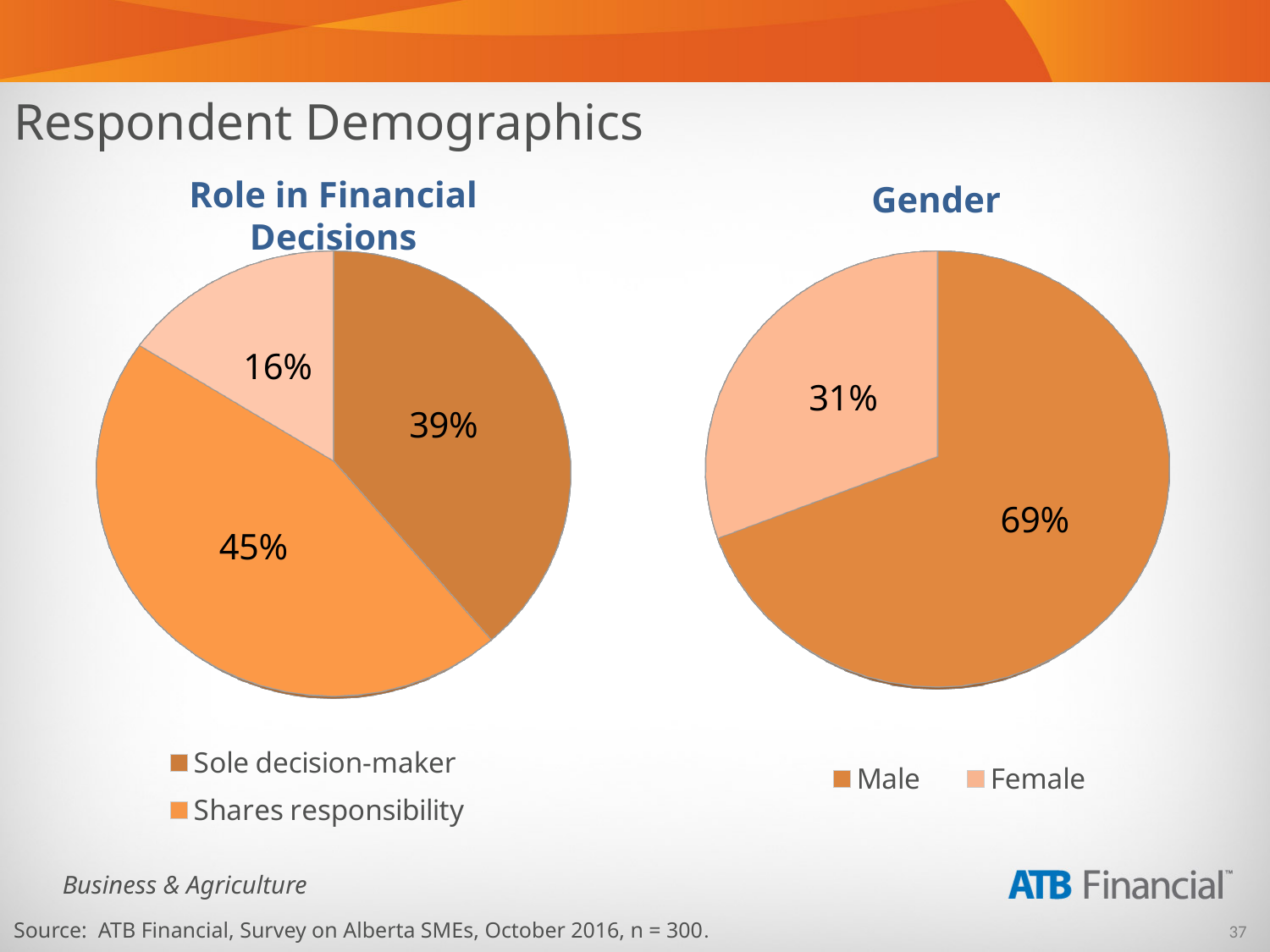
In the Gender chart, what is the difference in percentage points between Male and Female? 38 In the Gender chart, what percentage of respondents are male? 69% In the Role in Financial Decisions chart, what share of respondents share responsibility? 45% In the Gender chart, which category has the smaller slice? Female In the Role in Financial Decisions chart, what share of respondents are sole decision-makers? 39% In the Gender chart, what percentage of respondents are female? 31% In the Role in Financial Decisions chart, what is the difference in percentage points between Shares responsibility and Sole decision-maker? 6 How many slices does the Role in Financial Decisions chart have? 3 What type of chart is the Gender chart? Pie chart How many entries does the legend of the Gender chart list? 2 In the Role in Financial Decisions chart, which is larger: Sole decision-maker or Shares responsibility? Shares responsibility In the Role in Financial Decisions chart, which labelled category has the largest slice? Shares responsibility